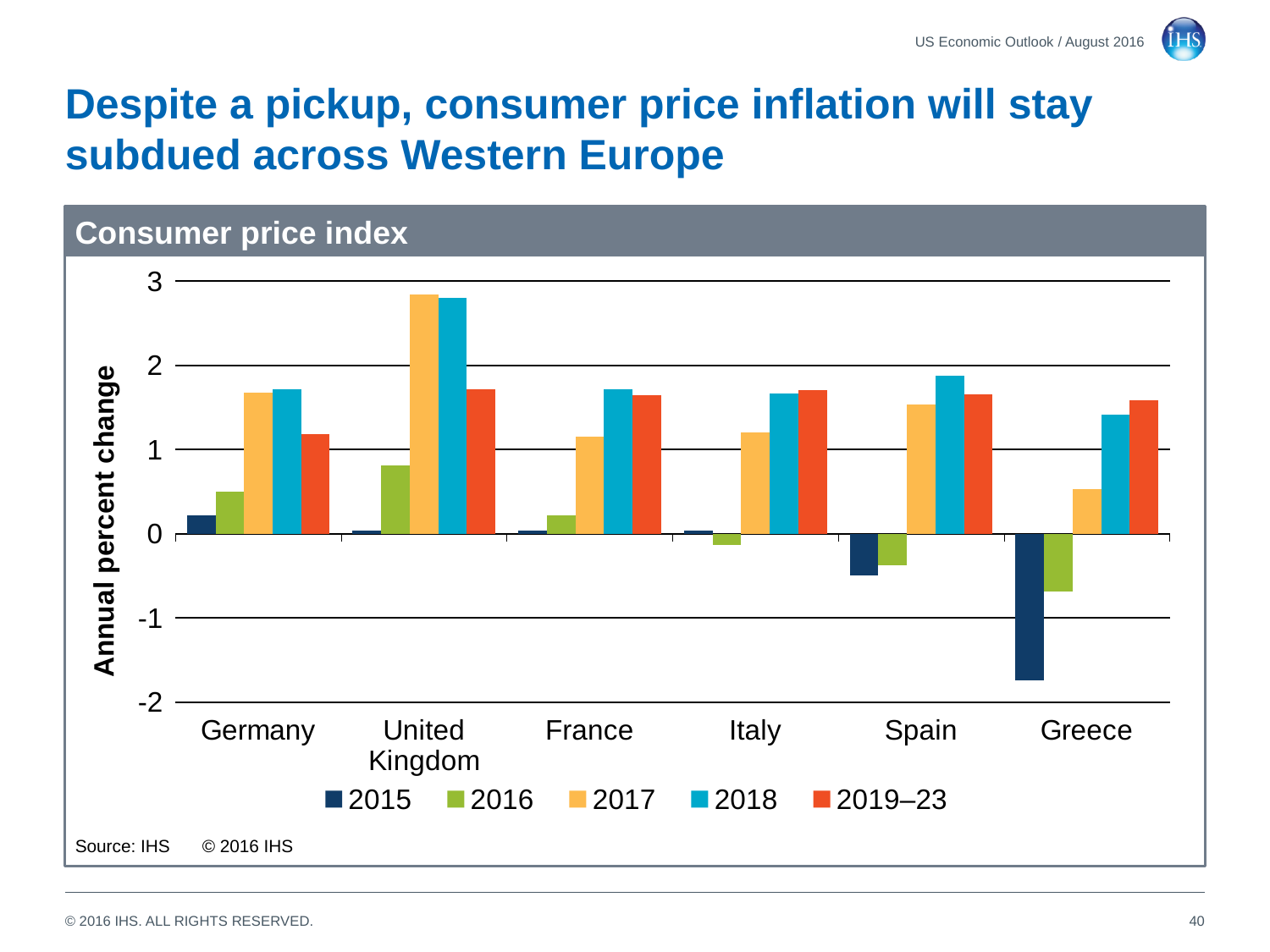
Do the values for Greece rise or fall from 2015 through 2019–23? rise Is the 2017 value for the United Kingdom greater or less than 2? greater What kind of chart is shown on the slide? bar chart How many series does the legend list? 5 Which is larger, the 2016 value for the United Kingdom or the 2016 value for France? United Kingdom Is the 2015 value for Greece greater or less than -1? less What is the title of the y axis? Annual percent change How many countries are shown on the x axis? 6 Is the 2018 value for Spain greater or less than 1? greater Which country has the highest 2017 value? United Kingdom Which country has the lowest 2015 value? Greece Which is larger, the 2016 value for Germany or the 2016 value for Greece? Germany